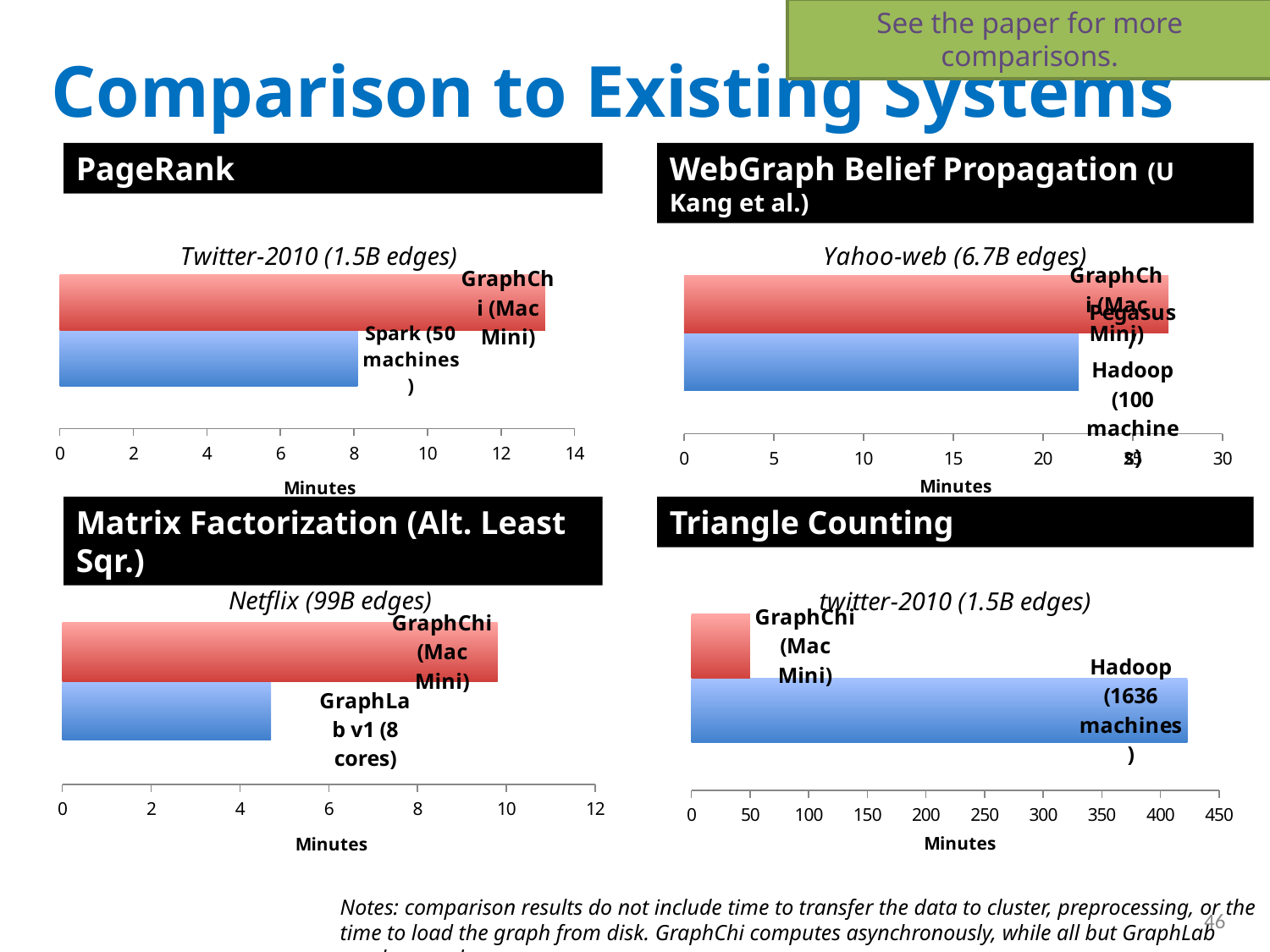
In the PageRank chart (Twitter-2010), is the value for Spark (50 machines) greater or less than 10? less In the PageRank chart (Twitter-2010), is the value for GraphChi (Mac Mini) greater or less than 12? greater In the WebGraph Belief Propagation chart (Yahoo-web), is the value for GraphChi (Mac Mini) greater or less than 25? greater In the PageRank chart (Twitter-2010), which system has the longer bar, GraphChi (Mac Mini) or Spark (50 machines)? GraphChi (Mac Mini) In the Triangle Counting chart (twitter-2010), which system has the highest value? Hadoop (1636 machines) In the Matrix Factorization chart (Netflix), which system has the lowest value? GraphLab v1 (8 cores) What is the x-axis title of the Triangle Counting chart? Minutes What kind of chart is the PageRank chart (Twitter-2010)? bar chart